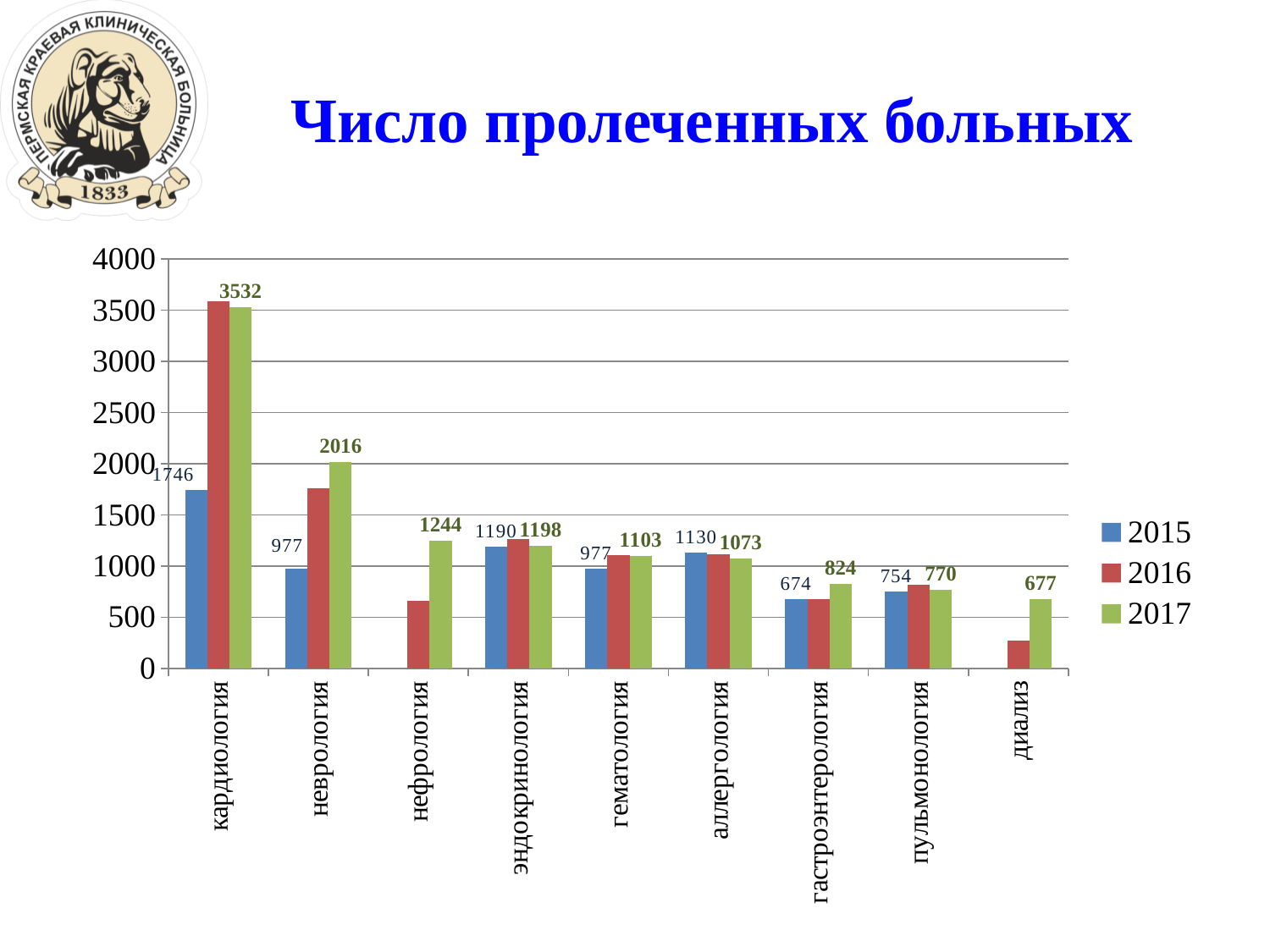
Which category has the highest value in 2017? кардиология What kind of chart is shown on the slide? bar chart Is the value for диализ in 2016 greater or less than 500? less What is the value for кардиология in 2017? 3532 What is the value for неврология in 2017? 2016 Which category has the lowest value in 2017? диализ What is the value for кардиология in 2015? 1746 How many categories are shown on the x axis? 9 Which is larger for неврология: the 2015 value or the 2017 value? 2017 How many series does the legend list? 3 What is the difference between the 2017 and 2015 values for кардиология? 1786 What is the value for гастроэнтерология in 2015? 674